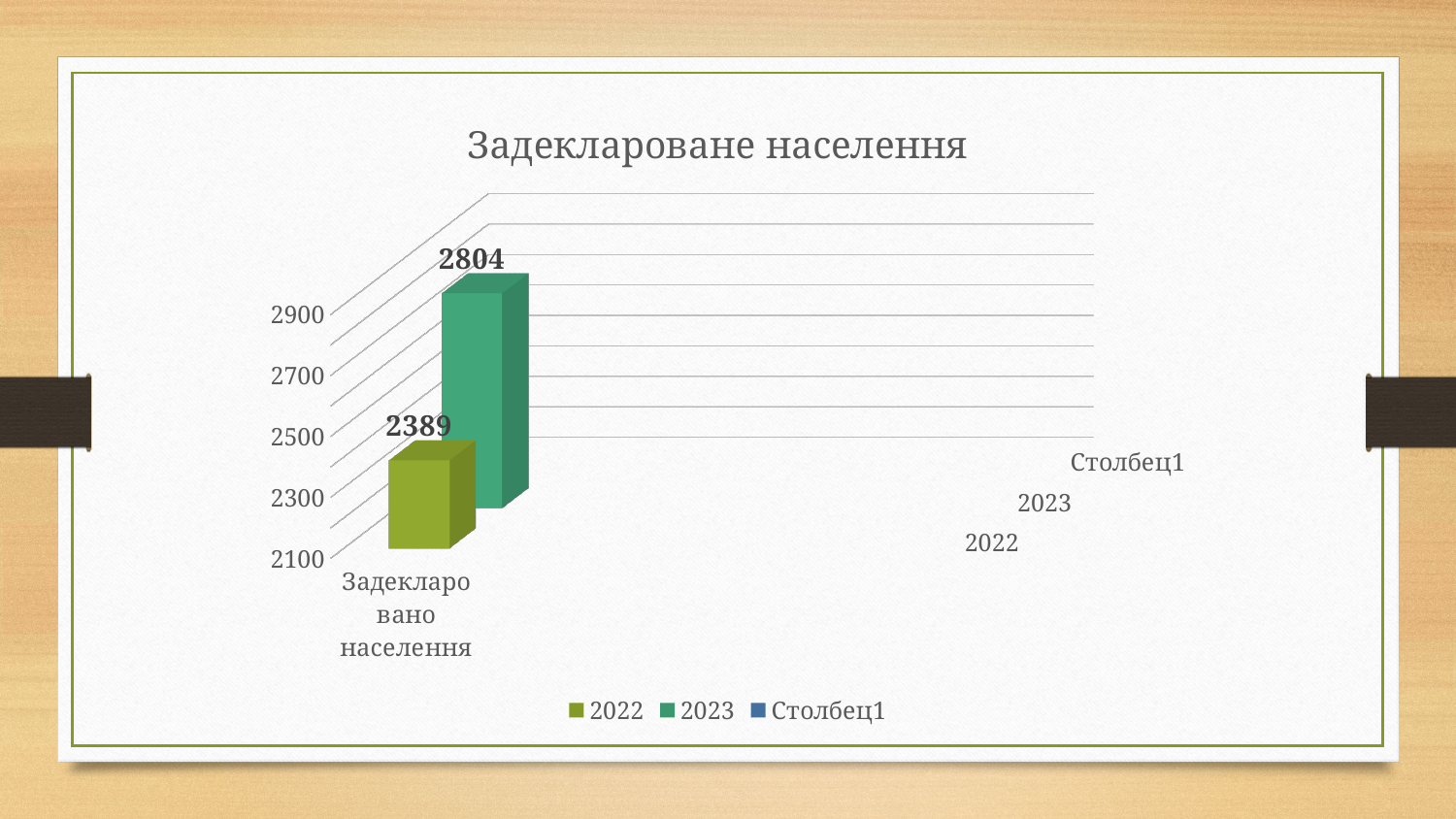
What is the value for 2022 in the chart? 2389 How many series does the legend list? 3 Which series has the higher value, 2022 or 2023? 2023 Which series has the highest plotted value? 2023 What is the difference between the 2023 value and the 2022 value? 415 What is the title of the chart? Задеклароване населення What kind of chart is shown on the slide? bar chart Which series has the lowest plotted value? 2022 What is the value for 2023 in the chart? 2804 What is the third entry in the chart legend? Столбец1 Is the value for 2022 greater or less than 2500? less Is the value for 2023 greater or less than 2700? greater